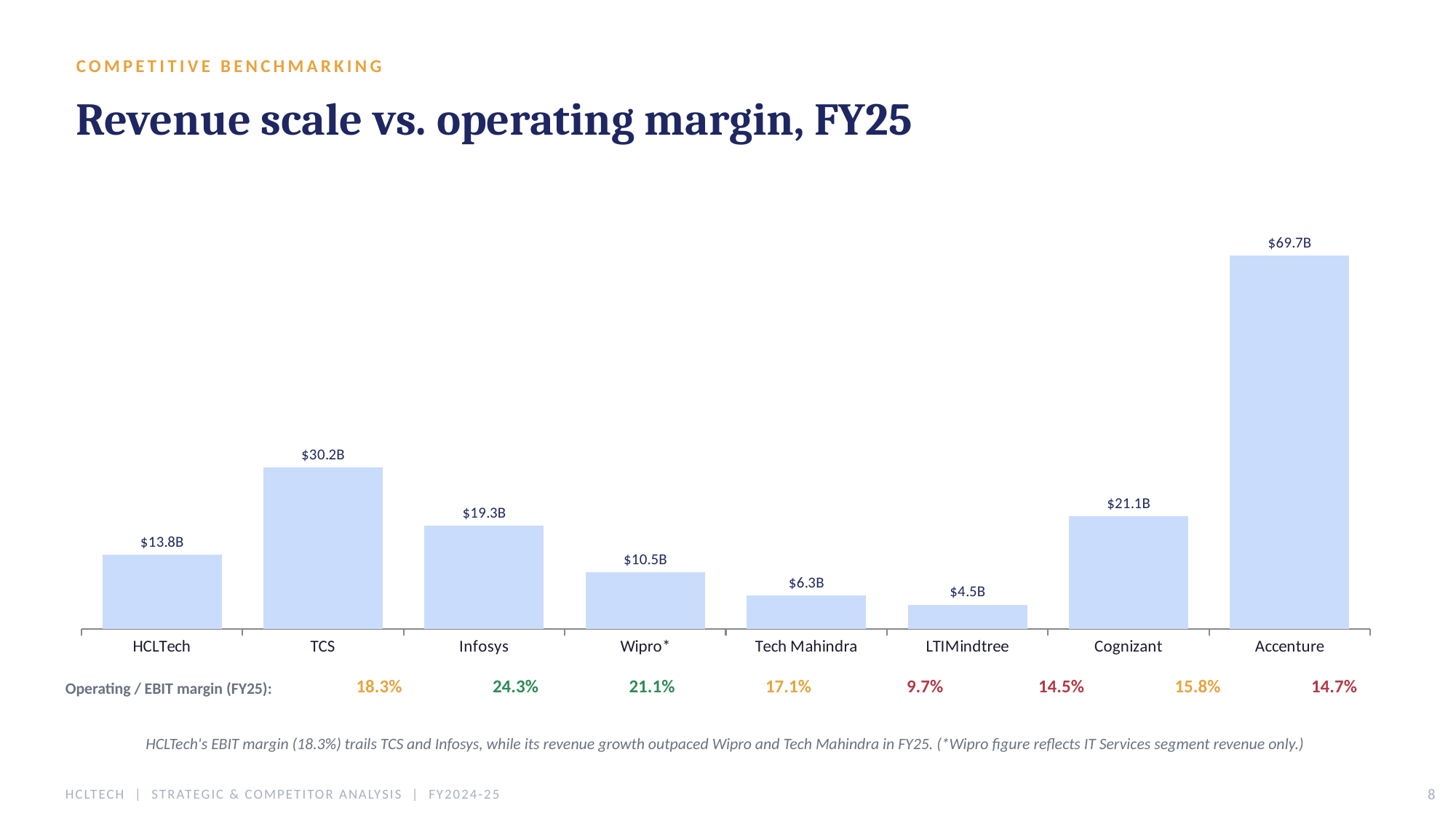
What is the title of the chart? Revenue scale vs. operating margin, FY25 What operating / EBIT margin is listed for TCS? 24.3% Which has higher revenue, Infosys or Cognizant? Cognizant What is the FY25 revenue shown for Accenture? $69.7B Which company has the lowest revenue in the chart? LTIMindtree How many companies are shown in the chart? 8 Which company has the highest revenue in the chart? Accenture What is the FY25 revenue shown for Cognizant? $21.1B What is the difference in revenue between Accenture and TCS? $39.5B What type of chart is shown on the slide? Bar chart What is the FY25 revenue shown for HCLTech? $13.8B What is the difference in revenue between TCS and HCLTech? $16.4B